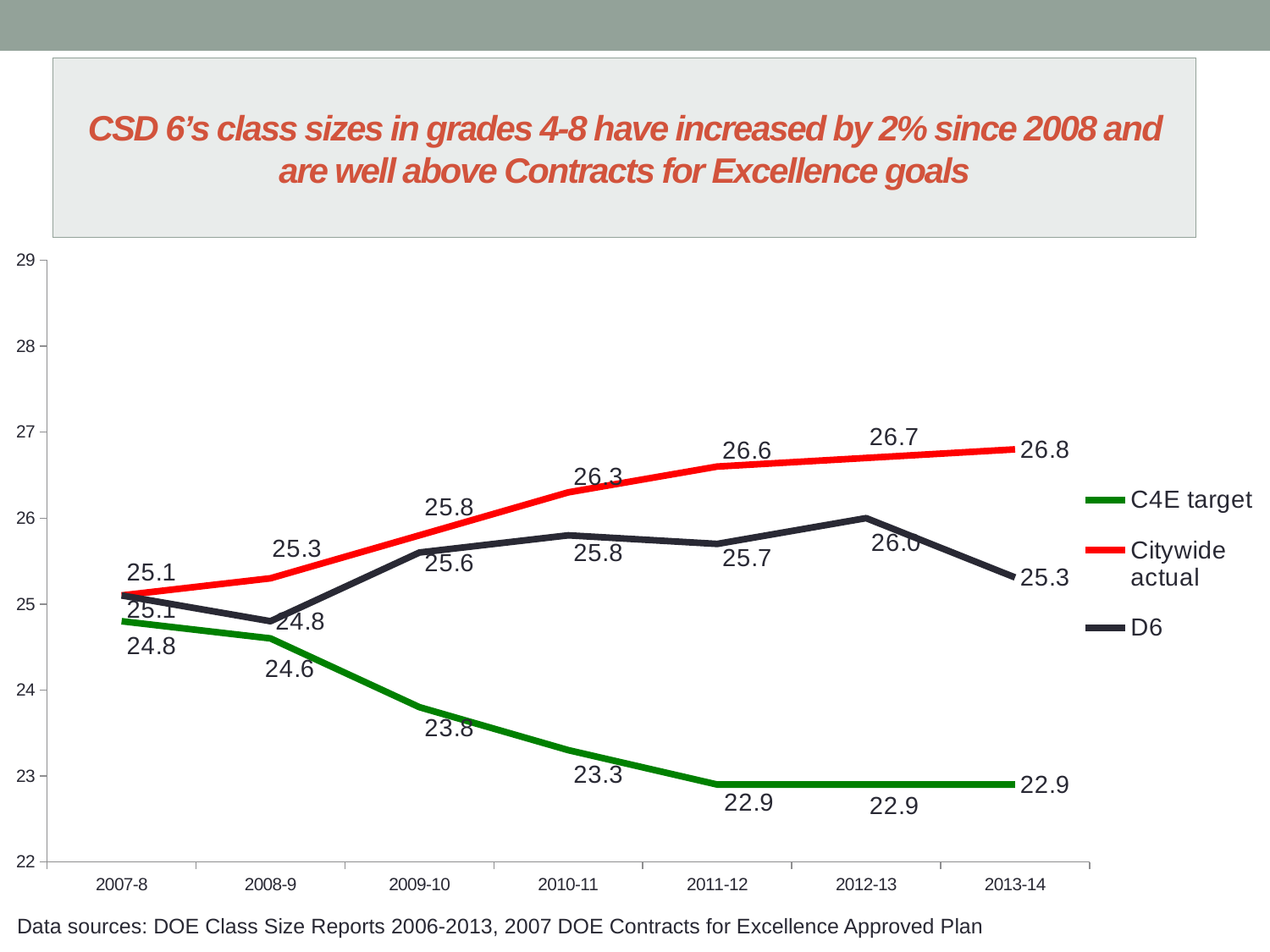
What colour is the line for the C4E target series? green What is the C4E target value for 2009-10? 23.8 Does the Citywide actual line rise or fall from 2007-8 to 2013-14? rise What is the difference between the Citywide actual and D6 values in 2013-14? 1.5 How many school years are shown on the x axis? 7 What is the D6 value for 2012-13? 26.0 What is the Citywide actual value for 2013-14? 26.8 Which is larger in 2011-12, the D6 value or the C4E target value? D6 In which year is the D6 value lowest? 2008-9 What kind of chart is shown on the slide? line chart How many series does the legend list? 3 In which year is the Citywide actual value highest? 2013-14